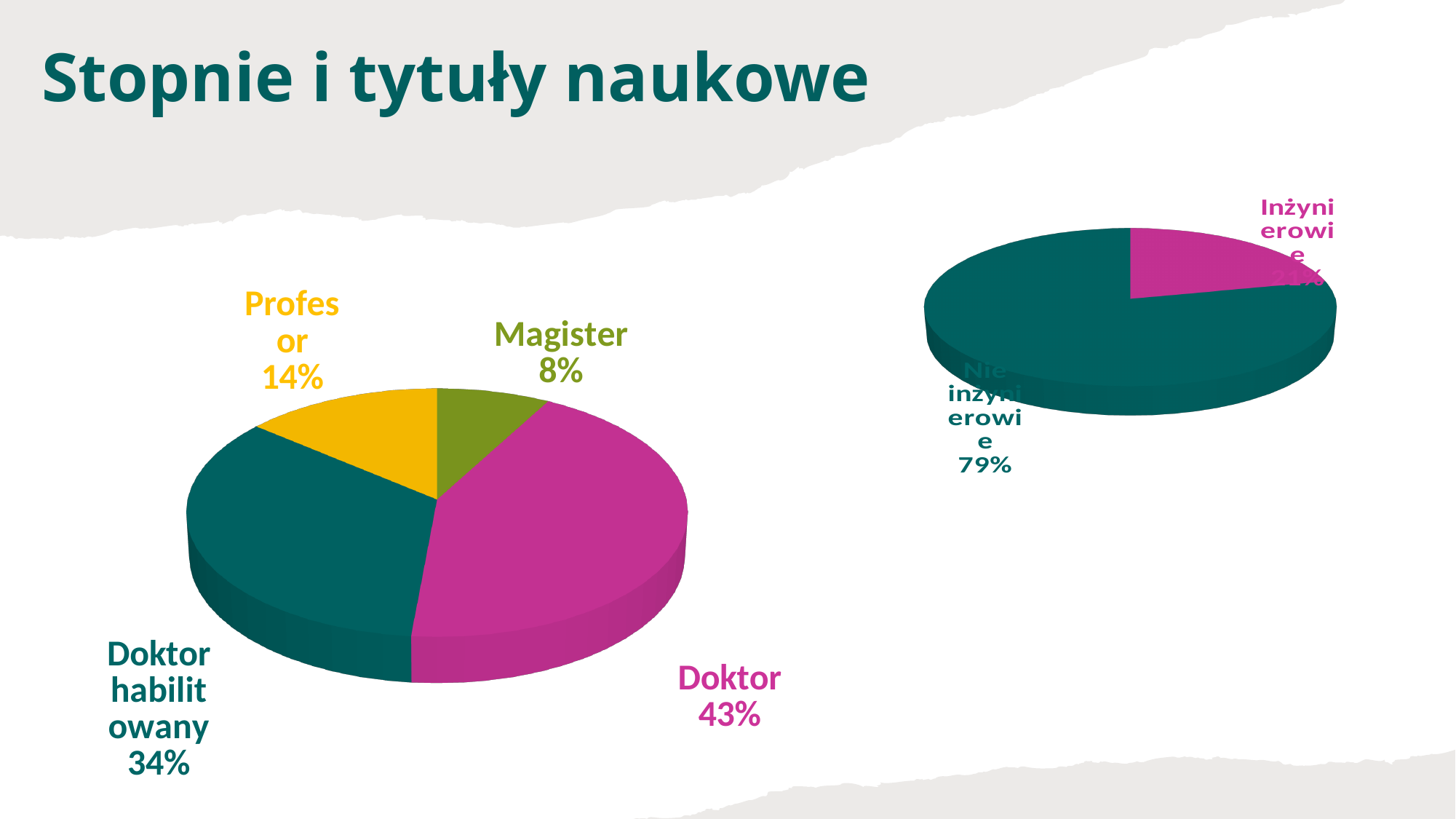
On the left pie chart, what share does Doktor have? 43% On the left pie chart, which category has the largest slice? Doktor On the right pie chart, which category has the larger slice? Nie inżynierowie On the left pie chart, which category has the smallest slice? Magister On the left pie chart, which is larger: Profesor or Magister? Profesor How many categories does the left pie chart show? 4 On the left pie chart, what share does Doktor habilitowany have? 34% On the left pie chart, what share does Magister have? 8% What kind of chart is the chart on the right of the slide? Pie chart On the left pie chart, what is the difference between the shares of Doktor and Doktor habilitowany? 9% On the left pie chart, what share does Profesor have? 14% On the right pie chart, what share does Nie inżynierowie have? 79%